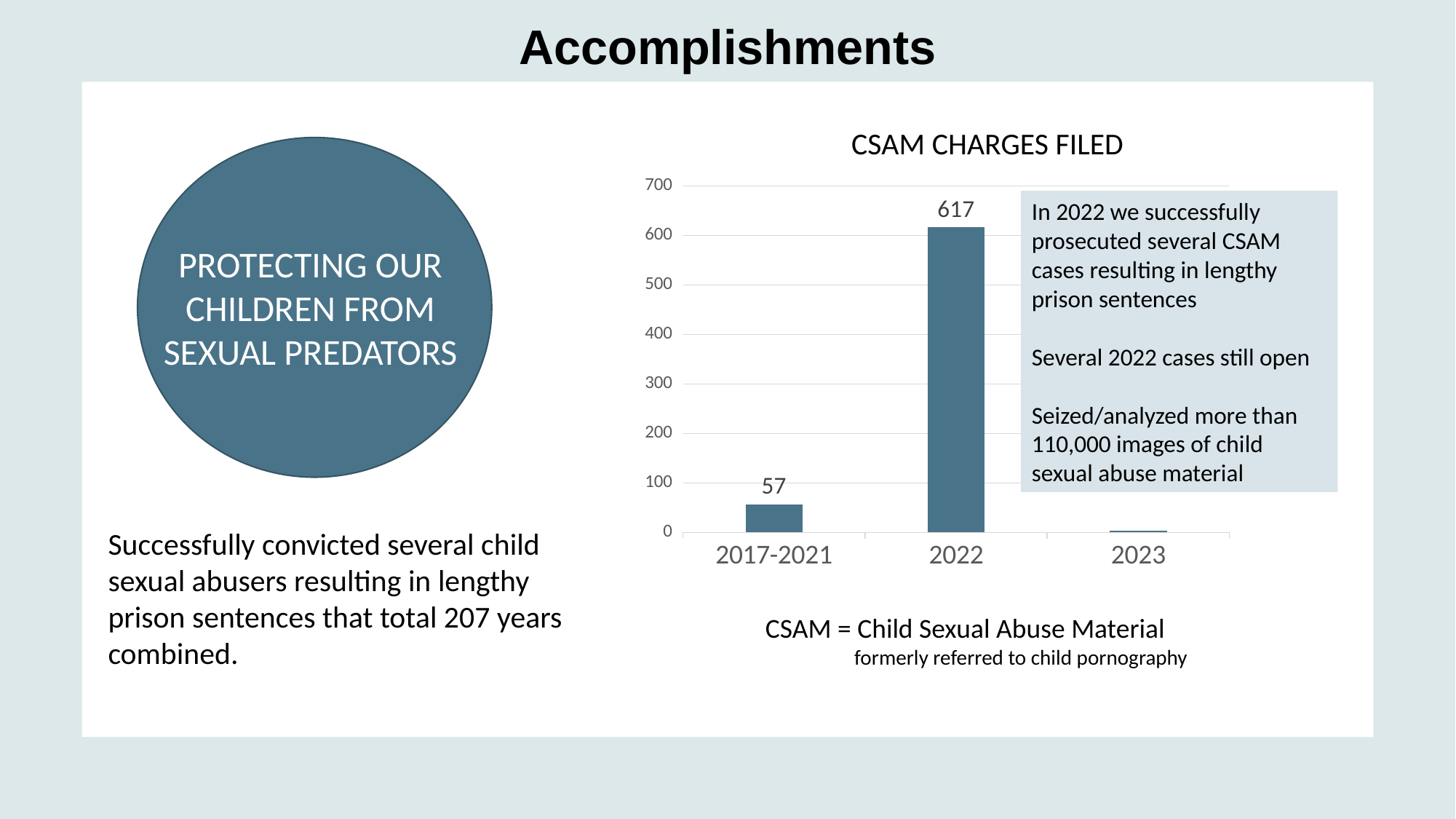
What kind of chart is the CSAM CHARGES FILED chart? bar chart How many categories are shown on the x axis of the CSAM CHARGES FILED chart? 3 What is the value for 2017-2021 in the CSAM CHARGES FILED chart? 57 Is the value for 2023 in the CSAM CHARGES FILED chart greater or less than 100? less Which category has the lowest value in the CSAM CHARGES FILED chart? 2023 Which is larger in the CSAM CHARGES FILED chart, the value for 2017-2021 or the value for 2023? 2017-2021 What is the difference between the values for 2022 and 2017-2021 in the CSAM CHARGES FILED chart? 560 Is the value for 2022 in the CSAM CHARGES FILED chart greater or less than 600? greater What is the value for 2022 in the CSAM CHARGES FILED chart? 617 Which category has the highest value in the CSAM CHARGES FILED chart? 2022 What is the title of the chart on the slide? CSAM CHARGES FILED What is the highest value shown on the y axis of the CSAM CHARGES FILED chart? 700